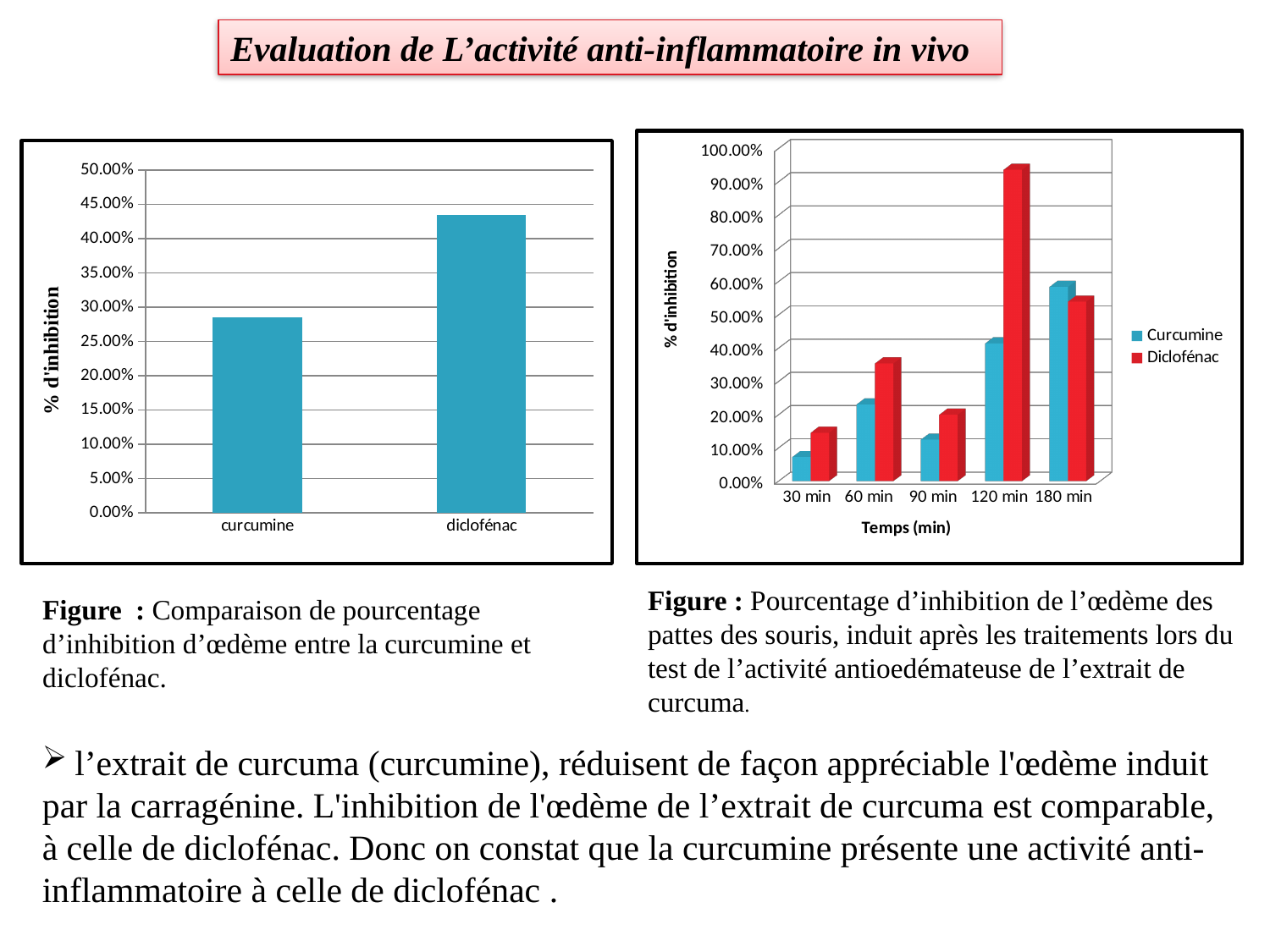
On the left chart, which category has the higher % d'inhibition? diclofénac On the right chart, how many series does the legend list? 2 On the right chart, how many time points are shown on the x axis? 5 What kind of chart is the left chart? bar chart On the left chart, is the value for diclofénac greater or less than 40.00%? greater On the left chart, is the value for curcumine greater or less than 25.00%? greater On the left chart, is the value for diclofénac greater or less than 45.00%? less On the right chart, at which time is the Curcumine value lowest? 30 min On the right chart, at which time is the Diclofénac value highest? 120 min On the left chart, how many categories are shown on the x axis? 2 On the right chart, at 120 min, which series has the larger value, Curcumine or Diclofénac? Diclofénac